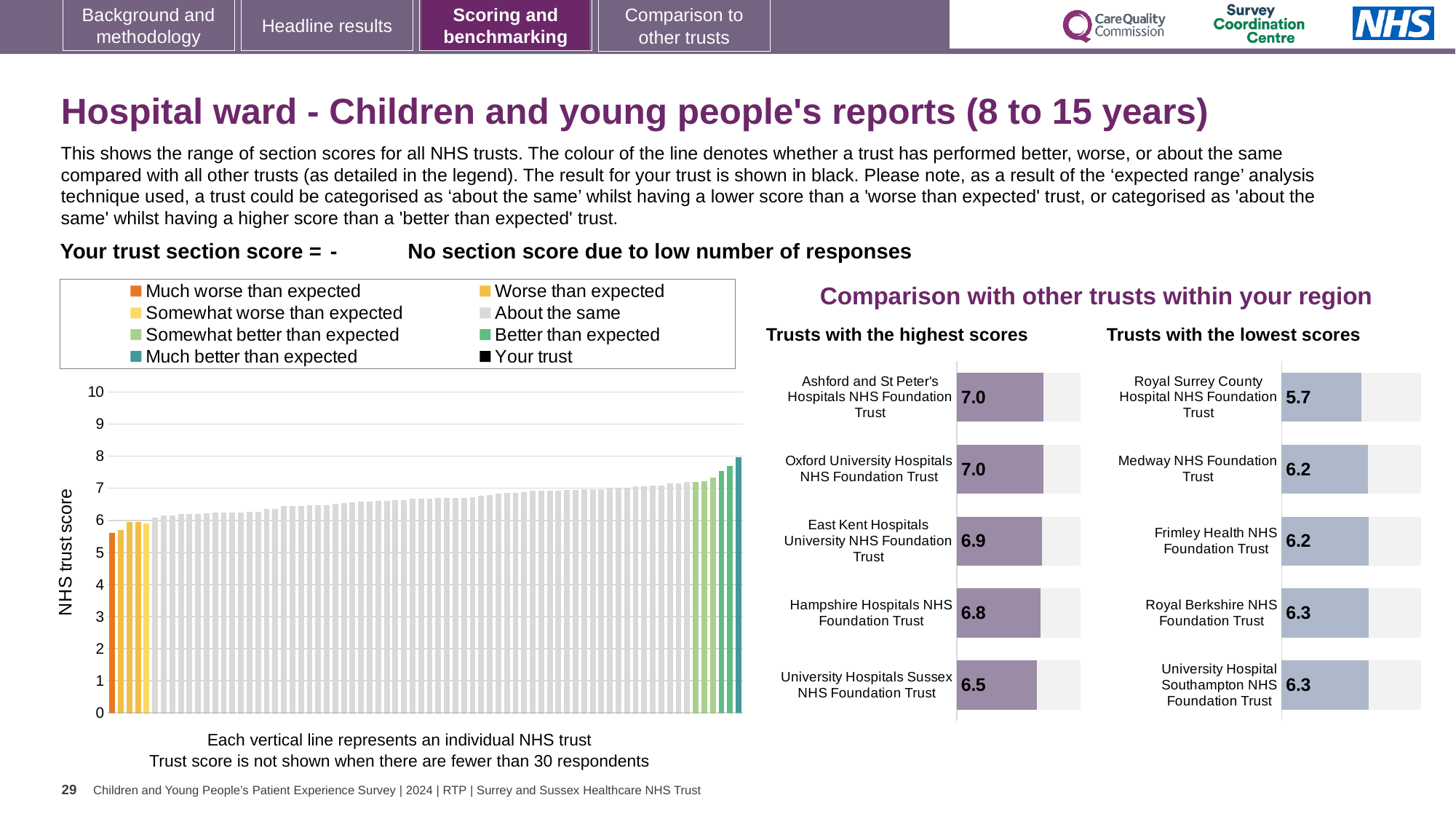
How many trusts are listed in the 'Trusts with the lowest scores' chart? 5 In the 'Trusts with the highest scores' chart, what is the score for East Kent Hospitals University NHS Foundation Trust? 6.9 In the 'Trusts with the highest scores' chart, which trust has the lowest score shown? University Hospitals Sussex NHS Foundation Trust In the 'NHS trust score' chart on the left, do the bar values rise or fall from left to right? Rise In the 'Trusts with the lowest scores' chart, which trust has the lowest score? Royal Surrey County Hospital NHS Foundation Trust In the 'Trusts with the lowest scores' chart, what is the score for Medway NHS Foundation Trust? 6.2 What is the difference between the score for Ashford and St Peter's Hospitals NHS Foundation Trust in the highest scores chart and the score for Royal Surrey County Hospital NHS Foundation Trust in the lowest scores chart? 1.3 In the 'Trusts with the lowest scores' chart, what is the score for Royal Surrey County Hospital NHS Foundation Trust? 5.7 What kind of chart is the 'NHS trust score' chart on the left of the slide? Bar chart In the 'Trusts with the highest scores' chart, what is the score for University Hospitals Sussex NHS Foundation Trust? 6.5 How many entries does the legend of the 'NHS trust score' chart on the left list? 8 In the 'Trusts with the highest scores' chart, which has the larger score: Hampshire Hospitals NHS Foundation Trust or University Hospitals Sussex NHS Foundation Trust? Hampshire Hospitals NHS Foundation Trust